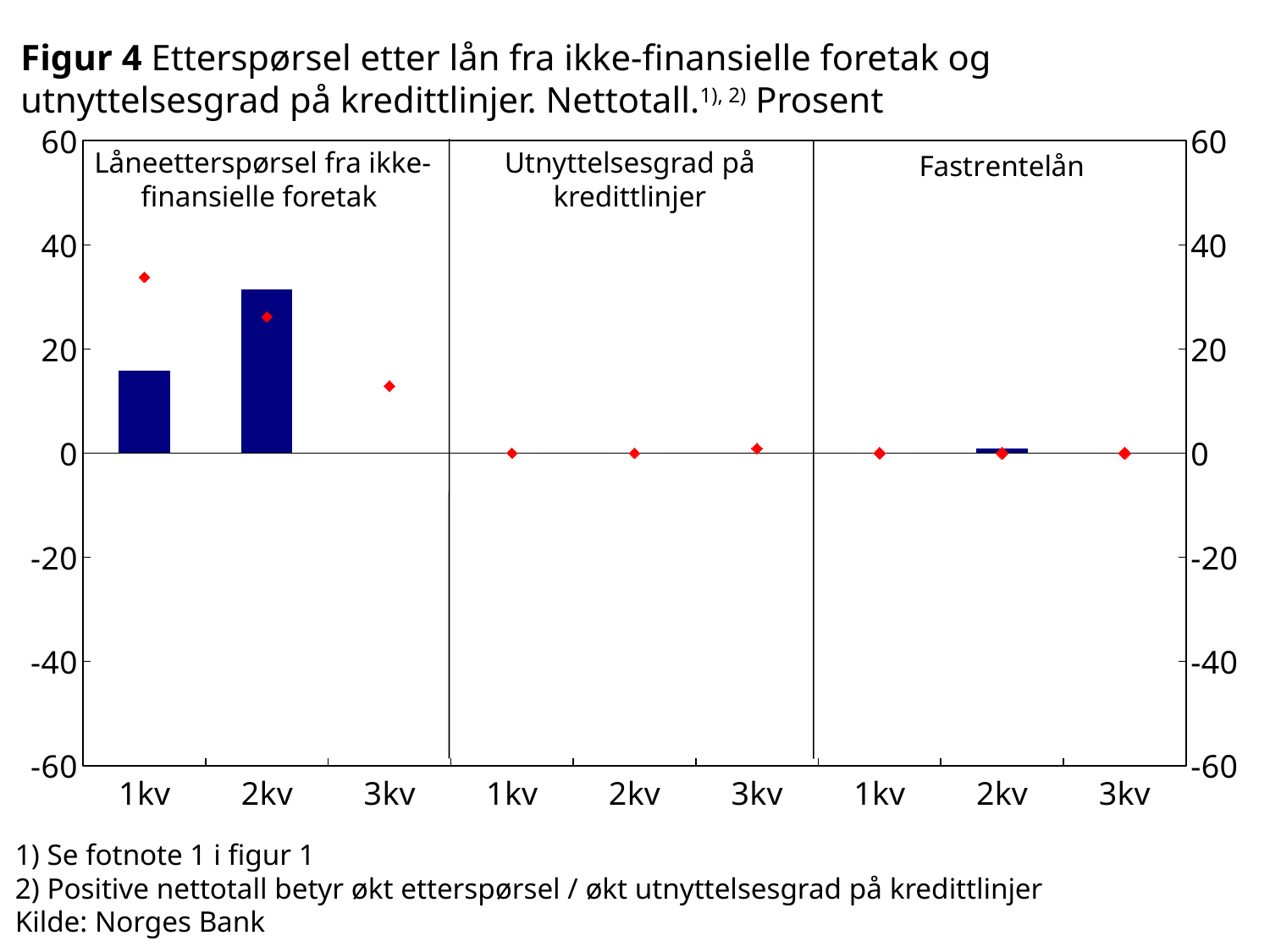
In the panel 'Låneetterspørsel fra ikke-finansielle foretak', is the bar for 2kv greater or less than 20? greater What is the title of the third panel of the chart? Fastrentelån What kind of chart is shown on the slide? combination chart (bars with diamond markers) What source is given for the chart? Norges Bank In the panel 'Låneetterspørsel fra ikke-finansielle foretak', which quarter has the tallest bar? 2kv In the panel 'Låneetterspørsel fra ikke-finansielle foretak', is the bar for 1kv greater or less than 20? less In the panel 'Låneetterspørsel fra ikke-finansielle foretak', which is larger, the bar for 1kv or the bar for 2kv? 2kv In the panel 'Låneetterspørsel fra ikke-finansielle foretak', is the red diamond for 3kv greater or less than 20? less How many panels (sections) does the chart have? 3 How many quarters are shown on the x axis within each panel? 3 In the panel 'Låneetterspørsel fra ikke-finansielle foretak', do the red diamonds rise or fall from 1kv to 3kv? fall